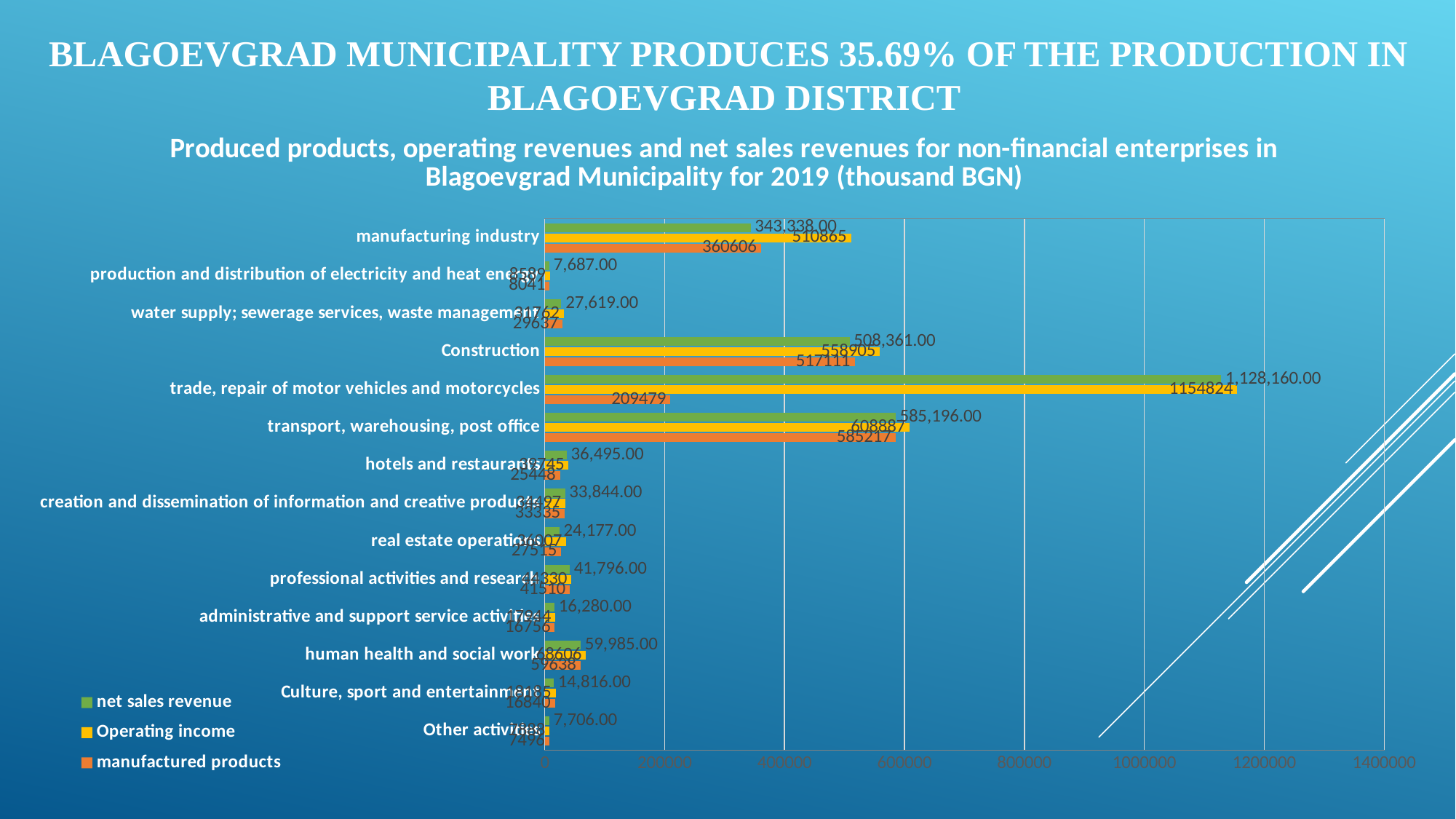
How many series does the legend list? 3 What is the net sales revenue for human health and social work? 59,985.00 Which colour represents Operating income in the legend? yellow Which has the larger value of manufactured products: Construction or transport, warehousing, post office? transport, warehousing, post office What is the operating income for trade, repair of motor vehicles and motorcycles? 1154824 Is the operating income for Construction greater or less than 400000? greater What kind of chart is shown on the slide? bar chart Which category has the highest net sales revenue? trade, repair of motor vehicles and motorcycles What is the value of manufactured products for the manufacturing industry? 360606 How many activity categories are plotted on the chart? 14 What is the difference in net sales revenue between trade, repair of motor vehicles and motorcycles and Construction? 619,799.00 What is the net sales revenue for Construction? 508,361.00